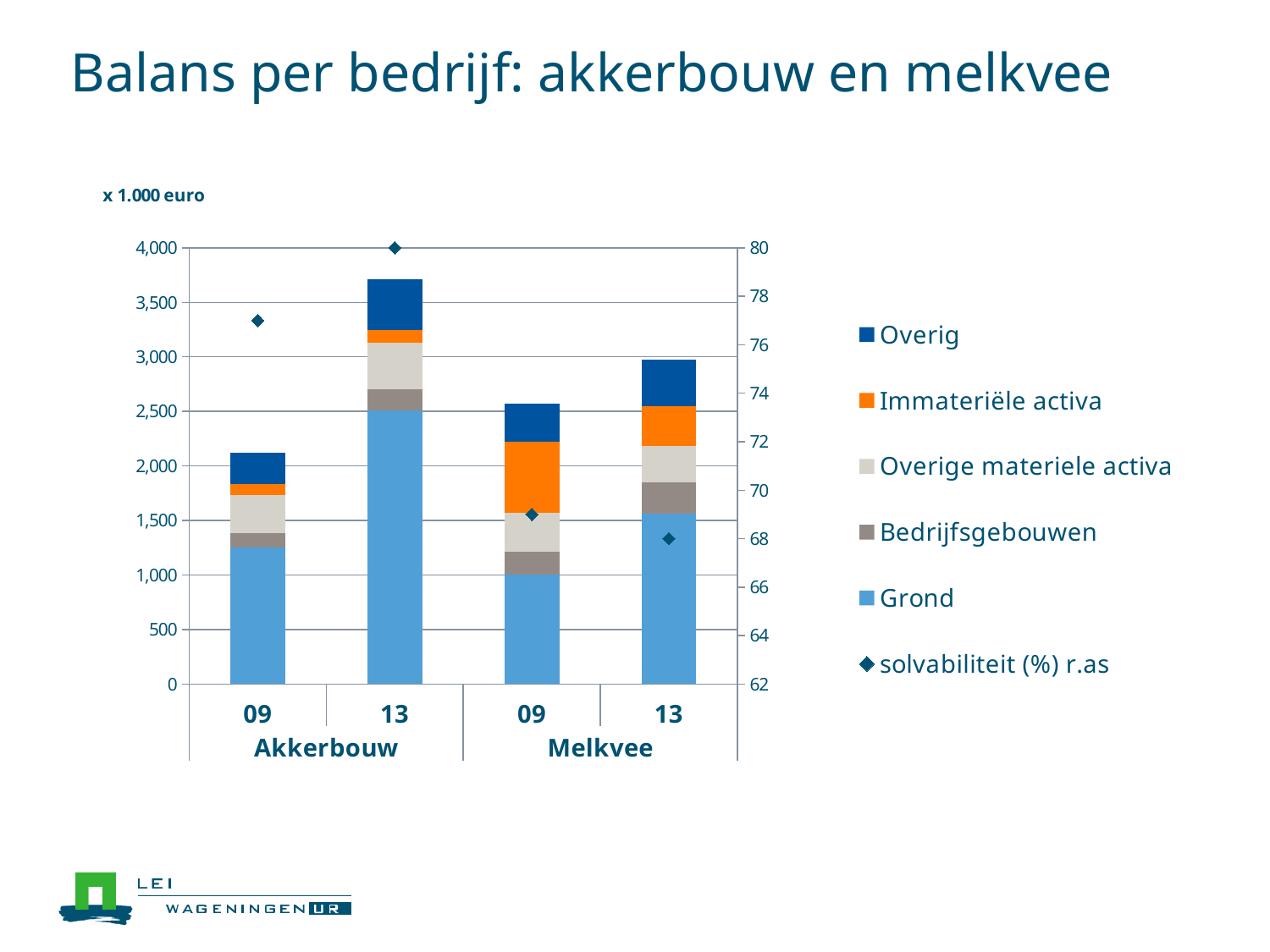
Which has the higher solvabiliteit (%): Akkerbouw 09 or Melkvee 09? Akkerbouw 09 Which bar has the highest total balance? Akkerbouw 13 Does the total balance for Akkerbouw rise or fall from 09 to 13? rise What unit is stated above the chart? x 1.000 euro Which bar has the lowest total balance? Akkerbouw 09 How many bars are plotted in the chart? 4 Which bar has the highest solvabiliteit (%) marker? Akkerbouw 13 Is the total for Melkvee 13 greater or less than 2,500? greater How many series does the legend list? 6 Is the total for Akkerbouw 13 greater or less than 3,500? greater What kind of chart is shown on the slide? bar chart Is the total for Akkerbouw 09 greater or less than 2,500? less